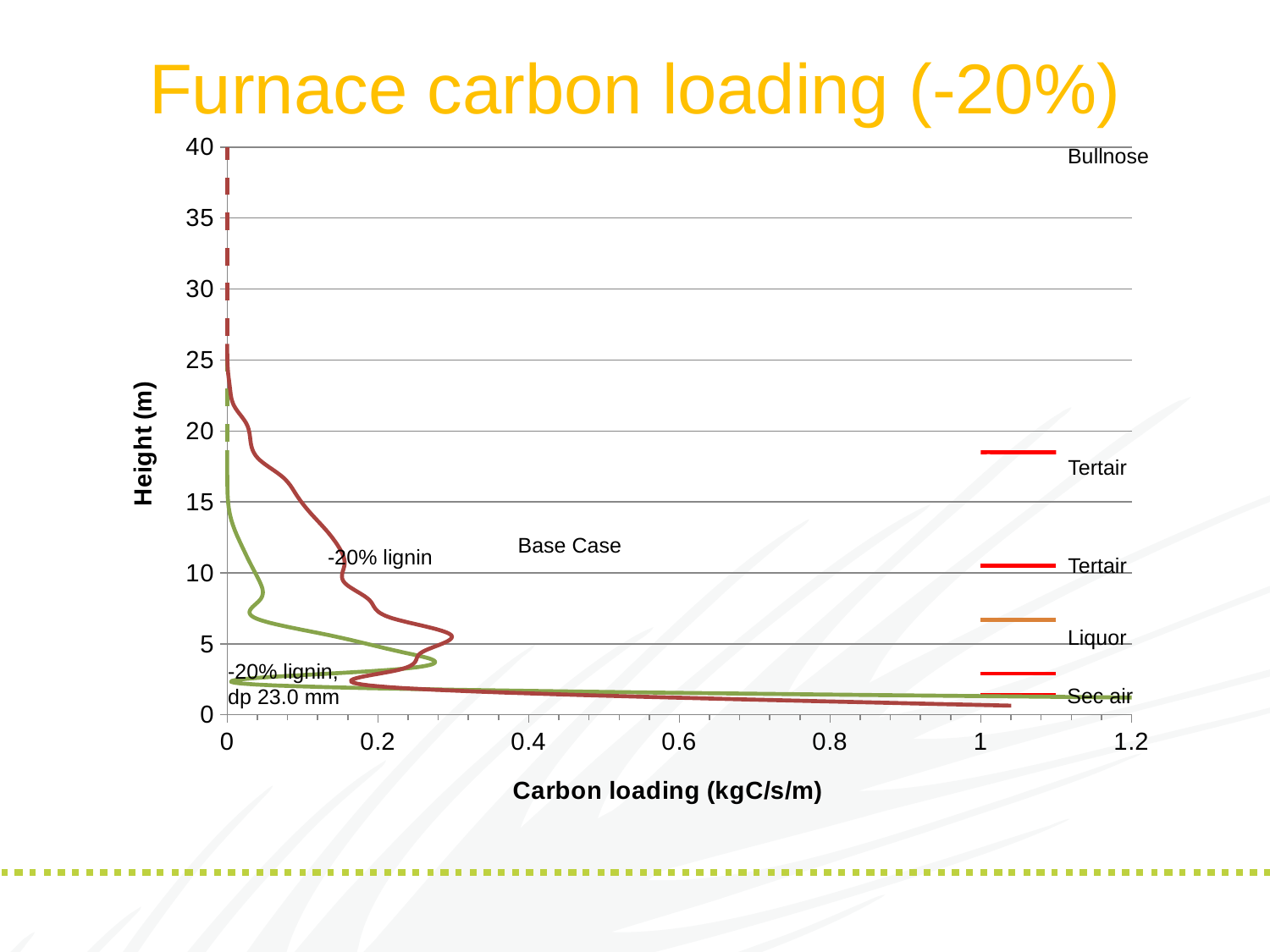
At a height of 5 m, which curve has the larger carbon loading, '-20% lignin' or '-20% lignin, dp 23.0 mm'? -20% lignin At a height of 10 m, is the carbon loading of the '-20% lignin, dp 23.0 mm' curve greater or less than 0.2? less Between heights of 5 m and 20 m, does the carbon loading of the '-20% lignin' curve rise or fall as height increases? fall At a height of 10 m, which curve has the larger carbon loading, '-20% lignin' or '-20% lignin, dp 23.0 mm'? -20% lignin What kind of chart is shown on the slide? line chart How many curves are plotted on the chart? 2 What is the title of the y axis of the chart? Height (m) What is the title of the x axis of the chart? Carbon loading (kgC/s/m) At a height of 15 m, is the carbon loading of the '-20% lignin' curve greater or less than 0.2? less What is the maximum value shown on the x axis of the chart? 1.2 At a height of 5 m, is the carbon loading of the '-20% lignin' curve greater or less than 0.2? greater